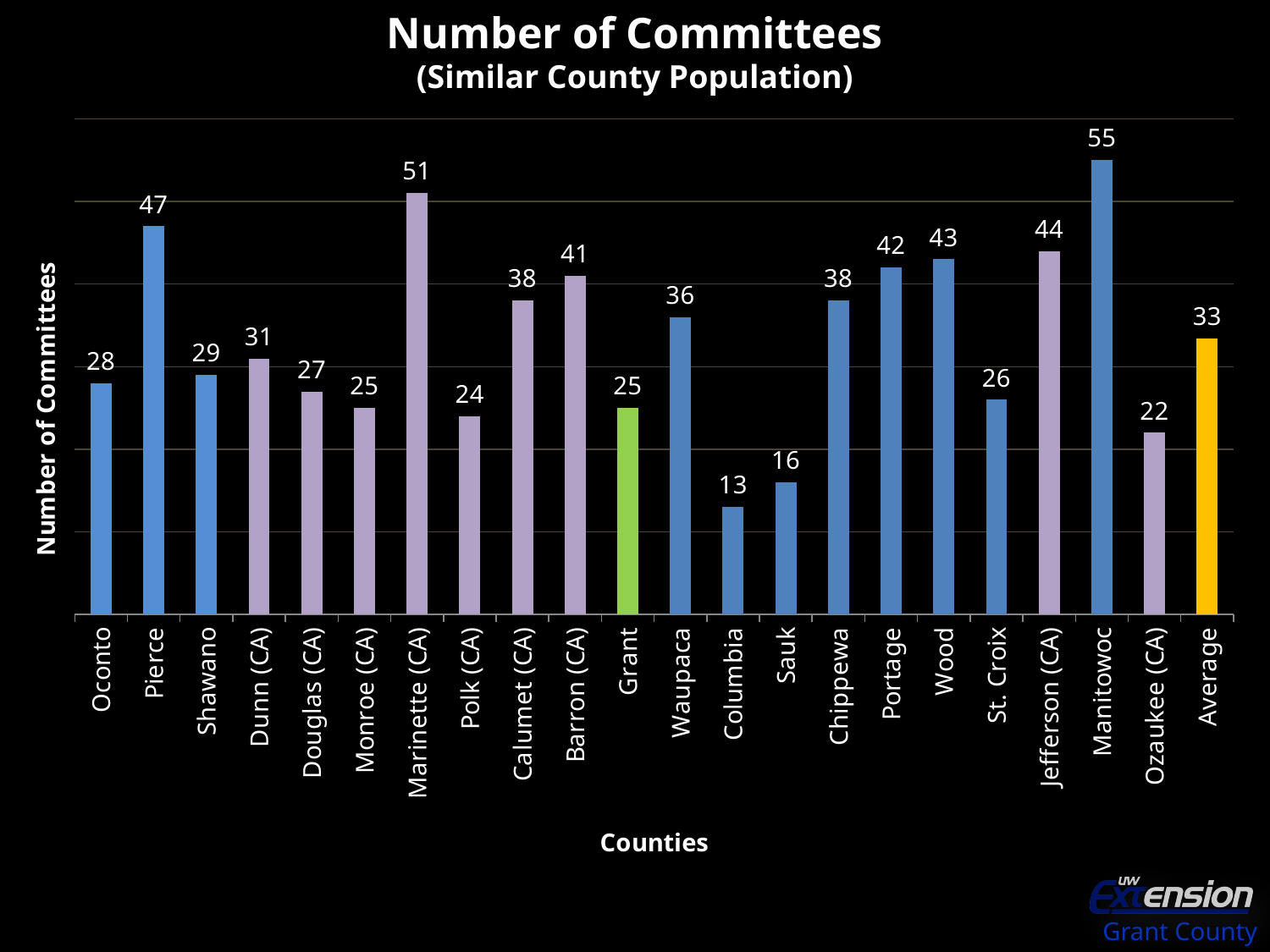
What type of chart is shown on the slide? Bar chart What is the number of committees for Grant? 25 Which county has the lowest number of committees? Columbia Which has fewer committees, Sauk or Ozaukee (CA)? Sauk What is the value shown for the Average bar? 33 What is the label of the x axis? Counties How many bars are shown on the chart, including the Average bar? 22 Which has more committees, Pierce or Jefferson (CA)? Pierce What is the difference between the Average value and Grant's value? 8 What is the difference in number of committees between Manitowoc and Grant? 30 Which county has the highest number of committees? Manitowoc What is the number of committees for Marinette (CA)? 51